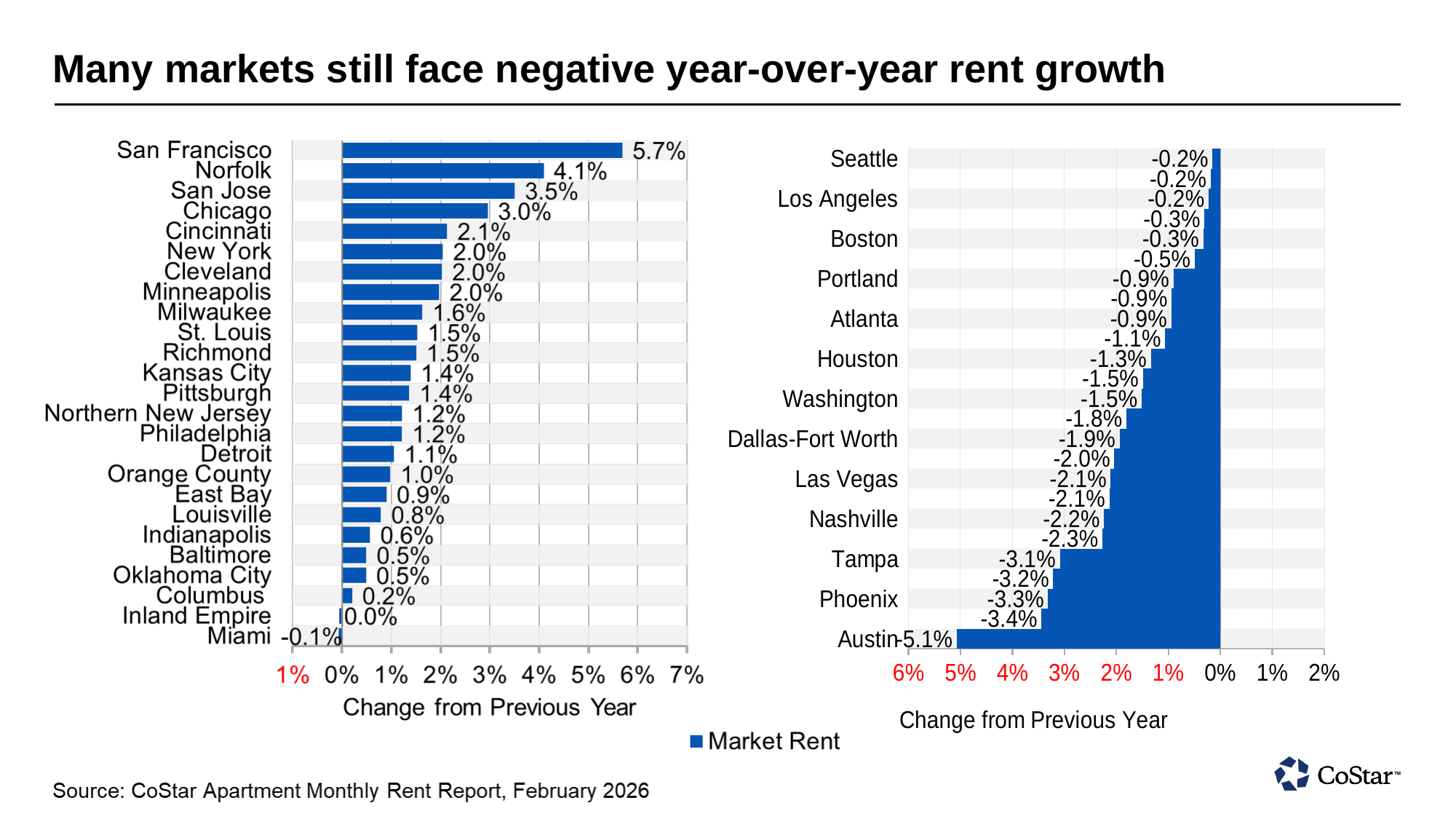
On the right chart, which market has the lowest (most negative) value? Austin On the right chart, what is the change from previous year for Austin? -5.1% On the left chart, which is larger, the value for Cincinnati or the value for Milwaukee? Cincinnati On the left chart, what is the value for Miami? -0.1% How many markets are shown on the left chart? 25 On the left chart, what is the value for Chicago? 3.0% What kind of chart is used on the left side of the slide? Bar chart On the left chart, which market has the lowest value? Miami On the left chart, which market has the highest rent growth? San Francisco On the left chart, what is the change from previous year for San Francisco? 5.7% On the left chart, what is the difference between San Francisco's and Norfolk's values? 1.6 percentage points On the right chart, what is the value for Houston? -1.3%